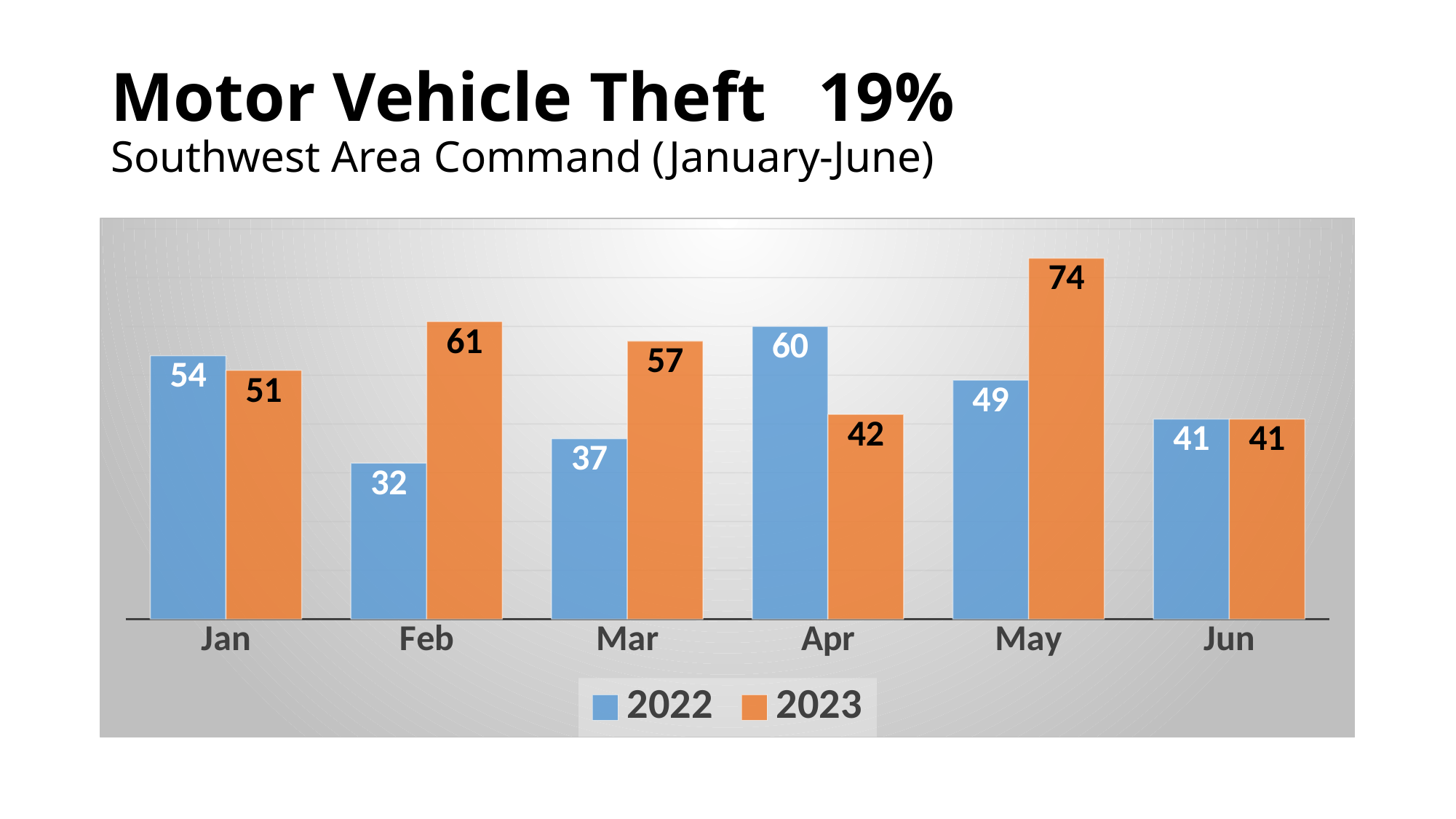
What is the value for 2022 in Jan? 54 What is the value for 2023 in May? 74 How many series does the legend list? 2 Which month has the lowest value for 2022? Feb How many months are shown on the x axis? 6 What kind of chart is shown on the slide? bar chart What colour represents the 2023 series in the legend? orange Which is larger in Apr, the 2022 value or the 2023 value? 2022 What is the difference between the 2023 and 2022 values in Feb? 29 What is the difference between the 2022 and 2023 values in Jun? 0 What is the value for 2023 in Apr? 42 Which month has the highest value for 2023? May